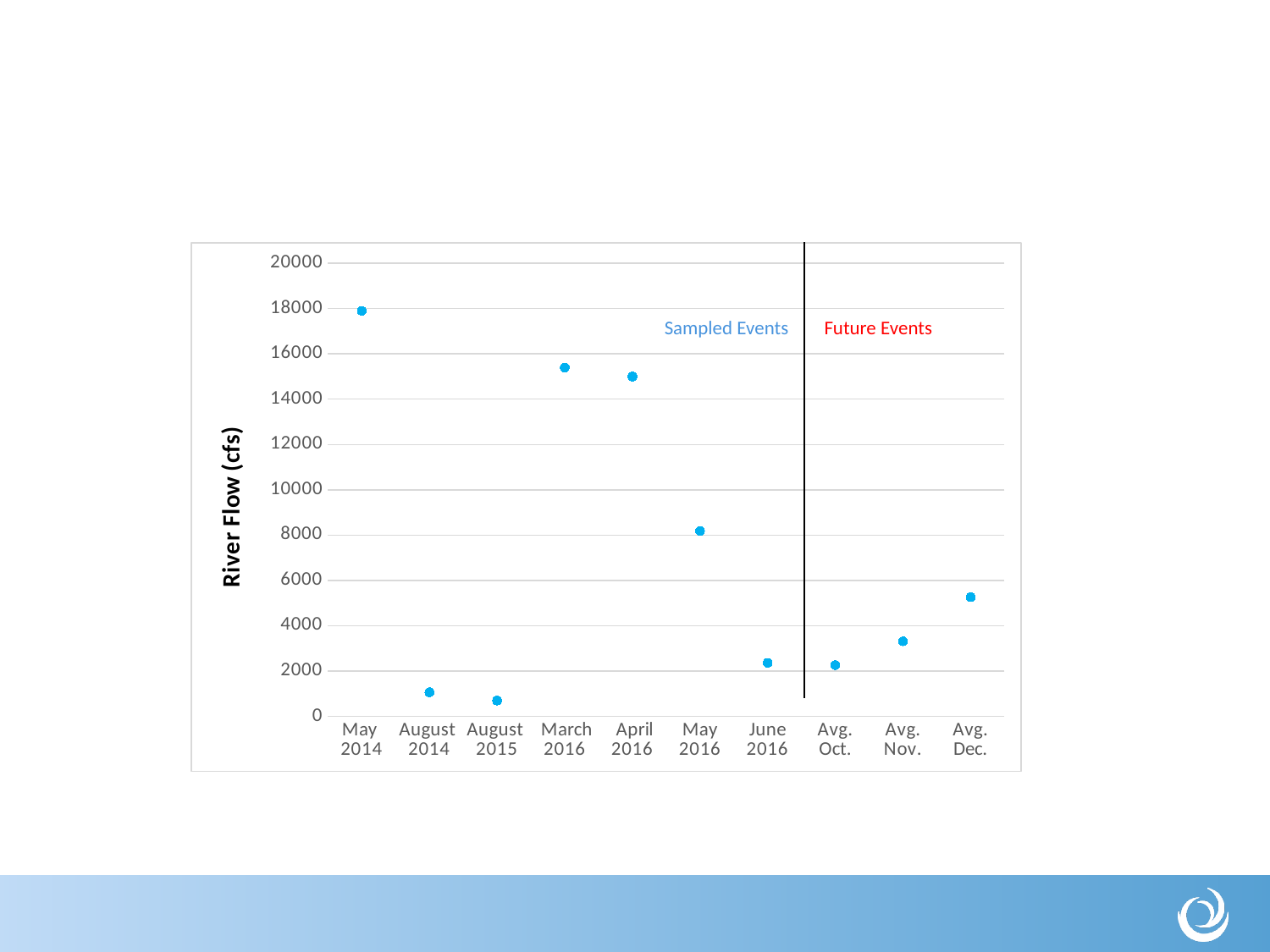
How many data points are plotted on the chart? 10 What kind of chart is shown on the slide? Scatter chart Is the river flow for May 2014 greater or less than 16000? greater Which has a higher river flow, May 2016 or June 2016? May 2016 Is the river flow for Avg. Dec. greater or less than 4000? greater What is the title of the vertical axis? River Flow (cfs) Is the river flow for May 2016 greater or less than 10000? less Which event has the highest river flow? May 2014 Which has a higher river flow, Avg. Oct. or Avg. Dec.? Avg. Dec. How many events are in the 'Future Events' section of the chart? 3